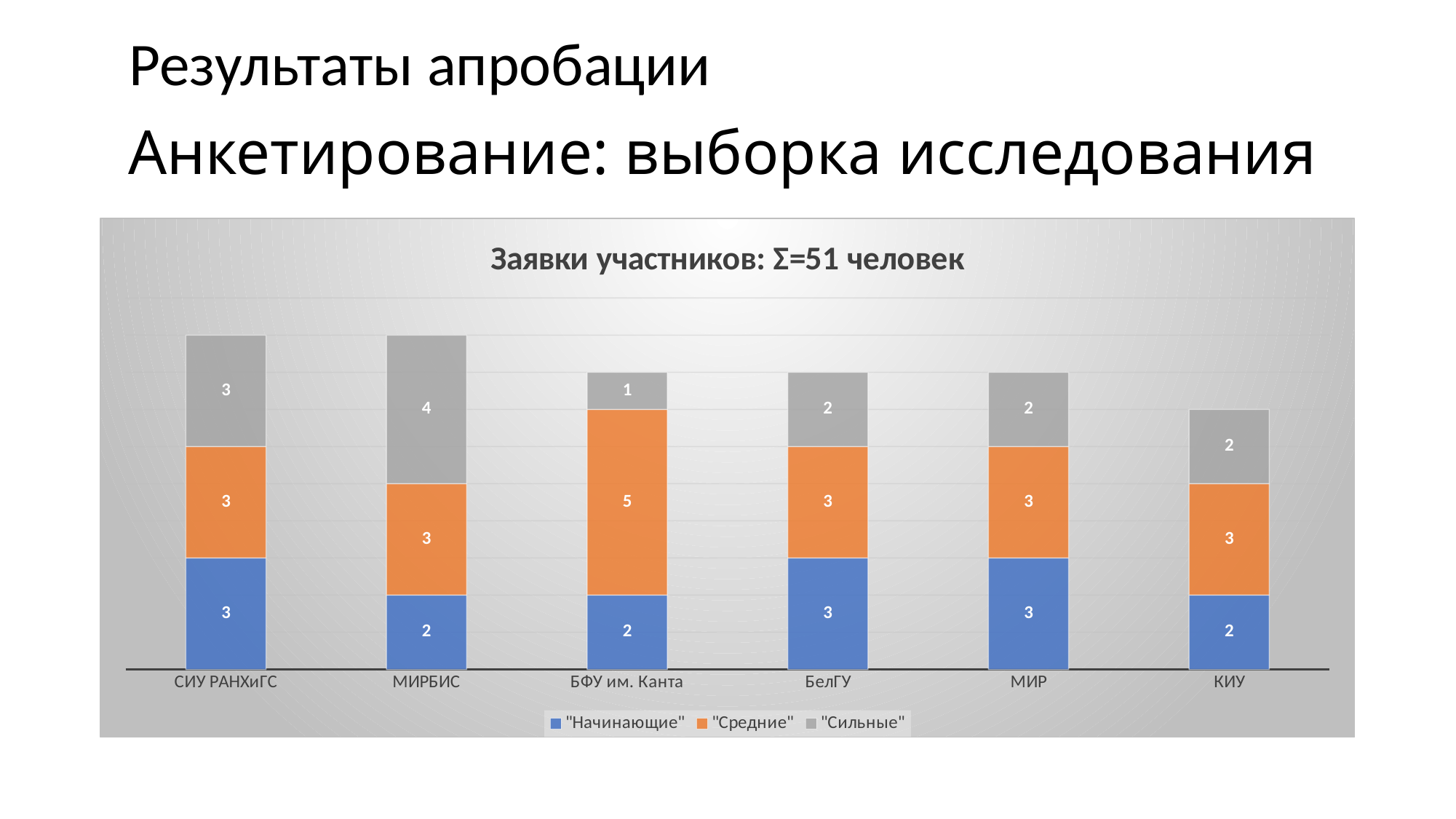
What is the title of the chart? Заявки участников: Σ=51 человек What is the value for "Средние" at БФУ им. Канта? 5 What is the total of the stacked bar for СИУ РАНХиГС? 9 What kind of chart is shown on the slide? Stacked bar chart What is the value for "Начинающие" at КИУ? 2 Which category has the highest value for "Сильные"? МИРБИС Which category has the lowest value for "Сильные"? БФУ им. Канта Which is larger: the "Начинающие" value at БелГУ or the "Начинающие" value at МИРБИС? БелГУ What is the value for "Сильные" at МИРБИС? 4 What is the difference between the "Средние" value at БФУ им. Канта and the "Средние" value at МИР? 2 How many categories are shown on the x axis? 6 How many series does the legend list? 3